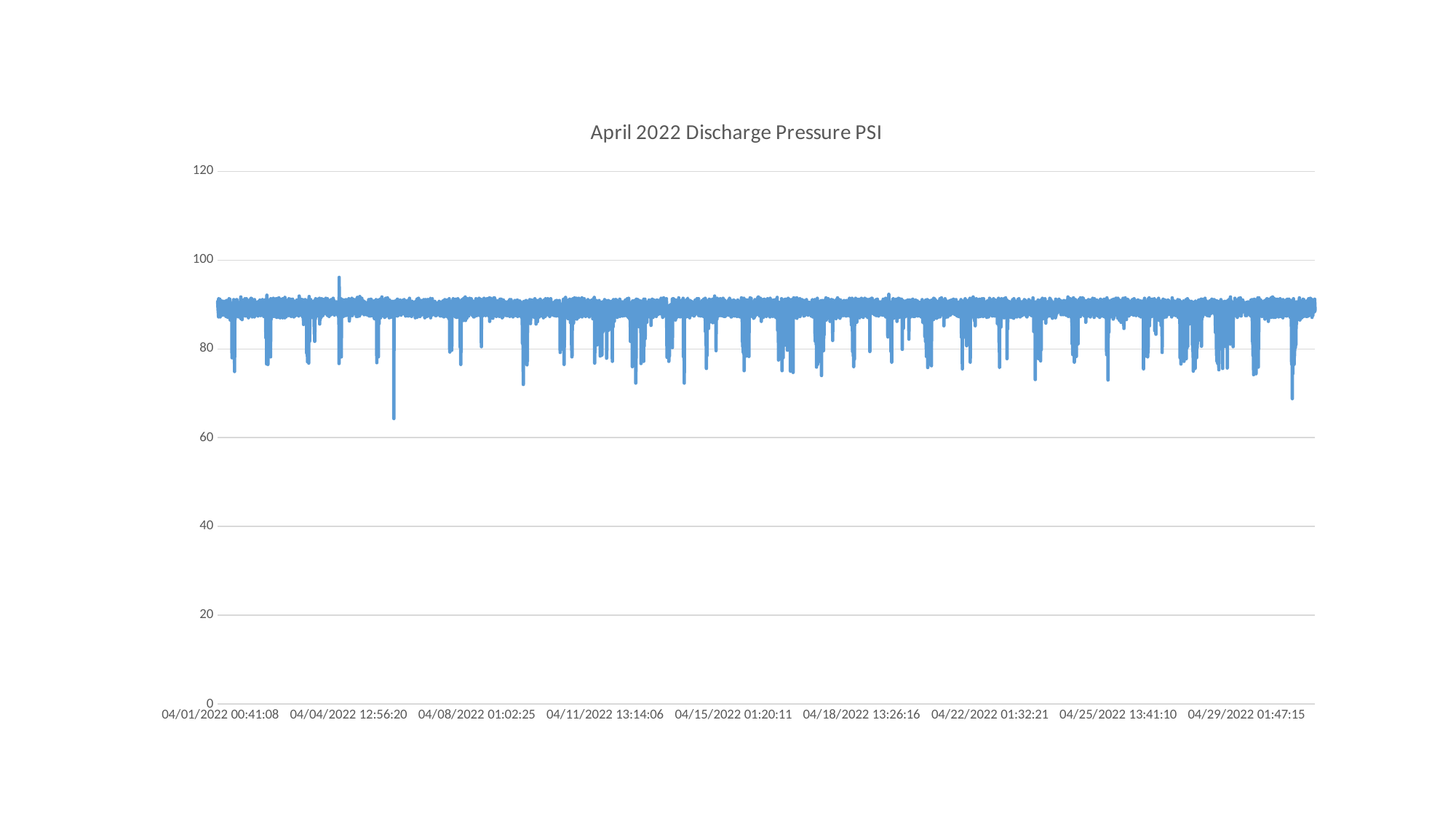
Is the highest value plotted on the chart greater or less than 100? less Is the typical discharge pressure level across April 2022 greater or less than 80? greater What is the title of the chart? April 2022 Discharge Pressure PSI Is the lowest dip on the chart, near 04/08/2022, greater or less than 80? less What is the last date label on the horizontal axis? 04/29/2022 01:47:15 What is the first date label on the horizontal axis? 04/01/2022 00:41:08 What is the highest value shown on the vertical axis? 120 What kind of chart is shown on the slide? line chart How many date labels are shown along the horizontal axis? 9 Over the month, does the discharge pressure show a strong rising trend, a strong falling trend, or stay roughly flat? roughly flat